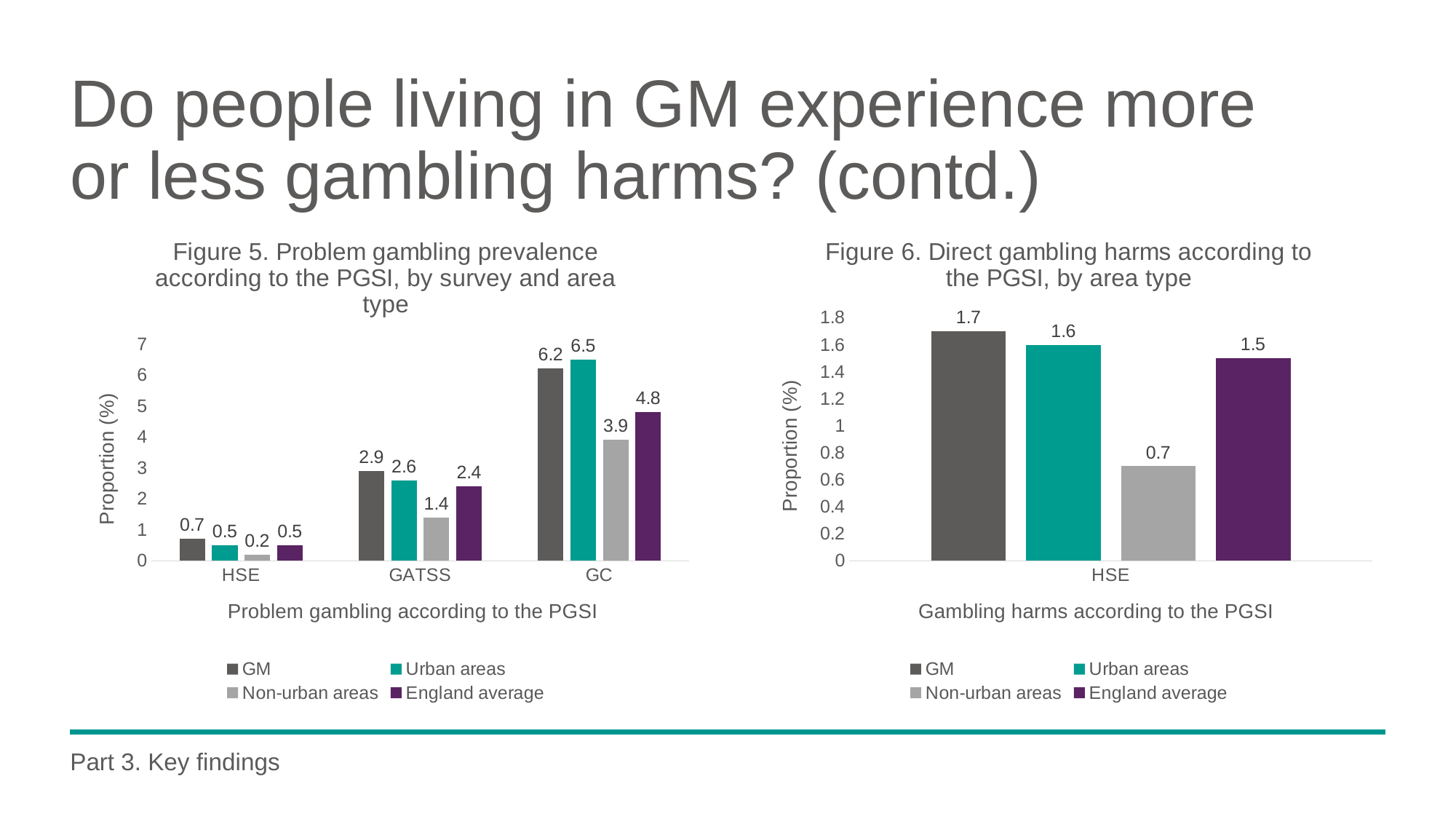
In Figure 5, what is the value for Non-urban areas in the GATSS survey? 1.4 In Figure 5, is the GM value for GATSS larger or smaller than the Urban areas value for GATSS? larger In Figure 5, which series has the lowest value for the HSE survey? Non-urban areas What kind of chart is Figure 6? bar chart In Figure 5, what is the value for Urban areas in the GC survey? 6.5 In Figure 5, how many survey categories are shown on the x axis? 3 In Figure 6, which series has the highest value? GM In Figure 6, what is the difference between the GM value and the Non-urban areas value? 1 In Figure 6, what is the value for Non-urban areas? 0.7 How many series does the legend of Figure 6 list? 4 In Figure 5, what is the difference between the GM value and the England average value for the GC survey? 1.4 In Figure 5, which series has the highest value for the GC survey? Urban areas